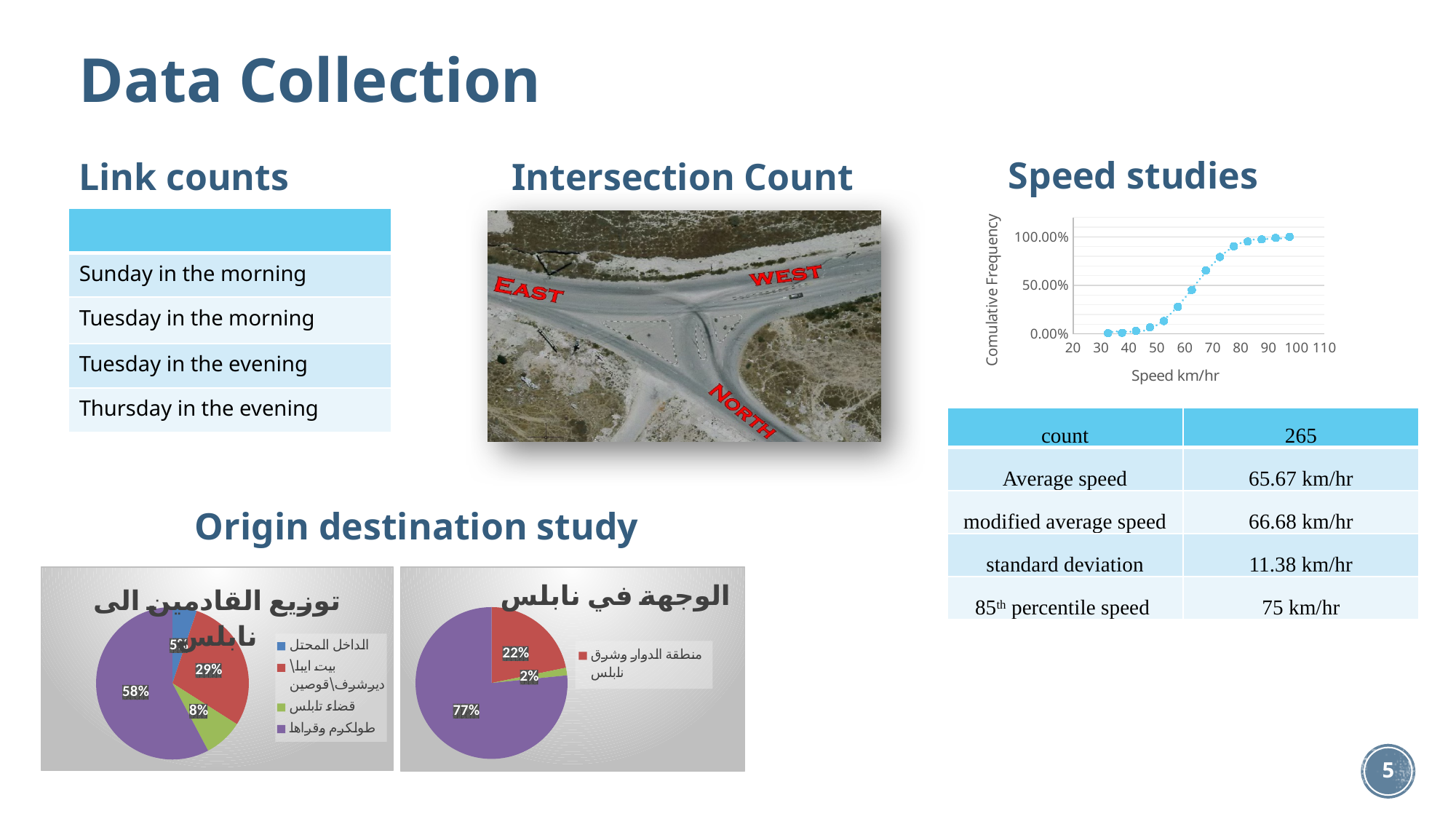
In the Speed studies chart, is the cumulative frequency at 80 km/hr greater or less than 50.00%? greater In the left pie chart (توزيع القادمين الى نابلس), which category has the largest slice? طولكرم وقراها In the right pie chart (الوجهة في نابلس), what is the share of the largest slice? 77% In the Speed studies chart, does the cumulative frequency rise or fall as speed increases along the x axis? rise What kind of chart is shown under "Speed studies"? scatter chart In the right pie chart (الوجهة في نابلس), what share does منطقة الدوار وشرق نابلس have? 22% In the Speed studies chart, is the cumulative frequency at 50 km/hr greater or less than 50.00%? less How many slices does the left pie chart (توزيع القادمين الى نابلس) have? 4 In the left pie chart (توزيع القادمين الى نابلس), what share does طولكرم وقراها have? 58% What is the title of the x axis of the Speed studies chart? Speed km/hr In the left pie chart (توزيع القادمين الى نابلس), what is the difference between the shares of طولكرم وقراها and بيت ايبا\ديرشرف\قوصين? 29 percentage points In the left pie chart (توزيع القادمين الى نابلس), what share does بيت ايبا\ديرشرف\قوصين have? 29%